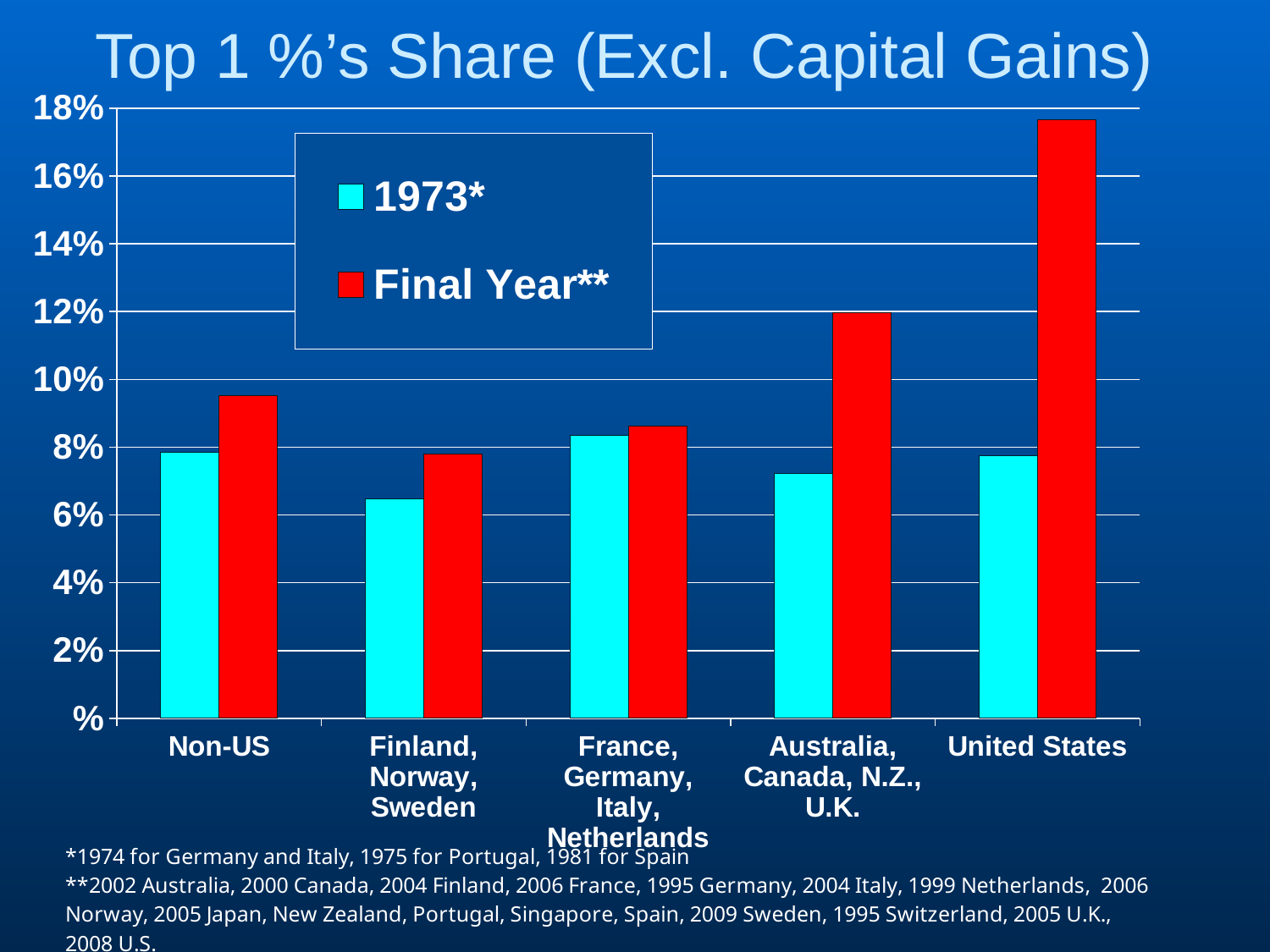
Is the 1973* value for Finland, Norway, Sweden greater or less than 6%? greater Is the Final Year** value for Non-US greater or less than 10%? less Which category has the highest 1973* value? France, Germany, Italy, Netherlands Which category has the lowest 1973* value? Finland, Norway, Sweden What kind of chart is shown on the slide? bar chart How many country groups are shown on the x axis? 5 How many series does the legend list? 2 Is the Final Year** value for United States greater or less than 16%? greater Which is larger: the Final Year** value for Australia, Canada, N.Z., U.K. or the Final Year** value for Non-US? Australia, Canada, N.Z., U.K. What colour are the Final Year** bars? red Which category has the highest Final Year** value? United States